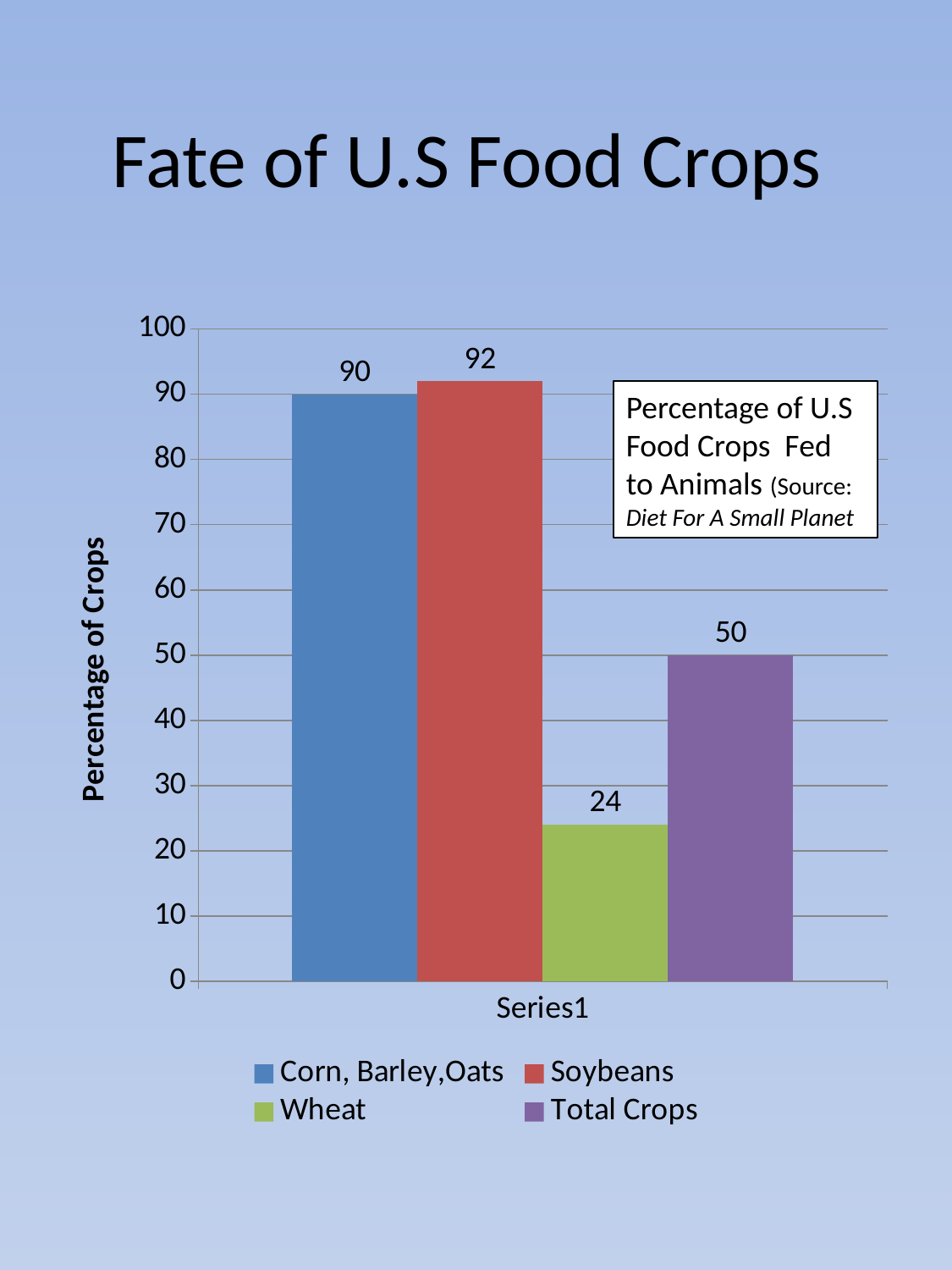
Is the value for Total Crops greater or less than 40? greater What is the difference between the values for Soybeans and Wheat? 68 What is the value for Total Crops? 50 Which is larger, the value for Total Crops or the value for Wheat? Total Crops What kind of chart is shown on the slide? bar chart Which series has the lowest value? Wheat How many series does the legend list? 4 What is the value for Corn, Barley,Oats? 90 Which series has the highest value? Soybeans What is the label on the vertical axis? Percentage of Crops What is the value for Wheat? 24 What is the value for Soybeans? 92